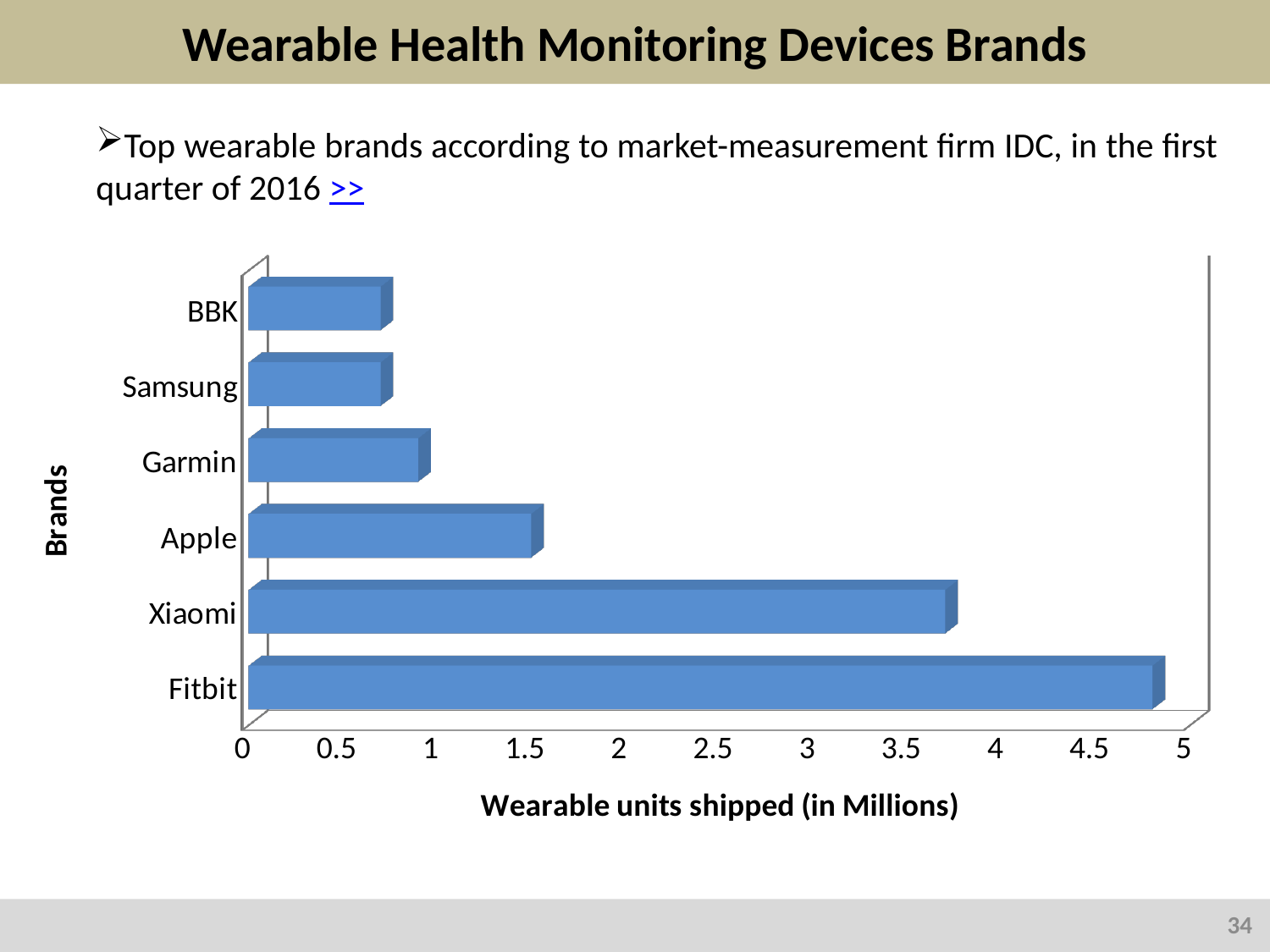
Is the value for Apple greater or less than 1? greater What is the title of the horizontal axis? Wearable units shipped (in Millions) What kind of chart is shown on the slide? bar chart Is the value for Samsung greater or less than 1? less Is the value for Apple greater or less than 2? less Which brand shipped more wearable units, Xiaomi or Apple? Xiaomi What is the title of the vertical axis? Brands Which brand has the highest number of wearable units shipped? Fitbit Which brand shipped more wearable units, Garmin or Samsung? Garmin How many brands are shown in the chart? 6